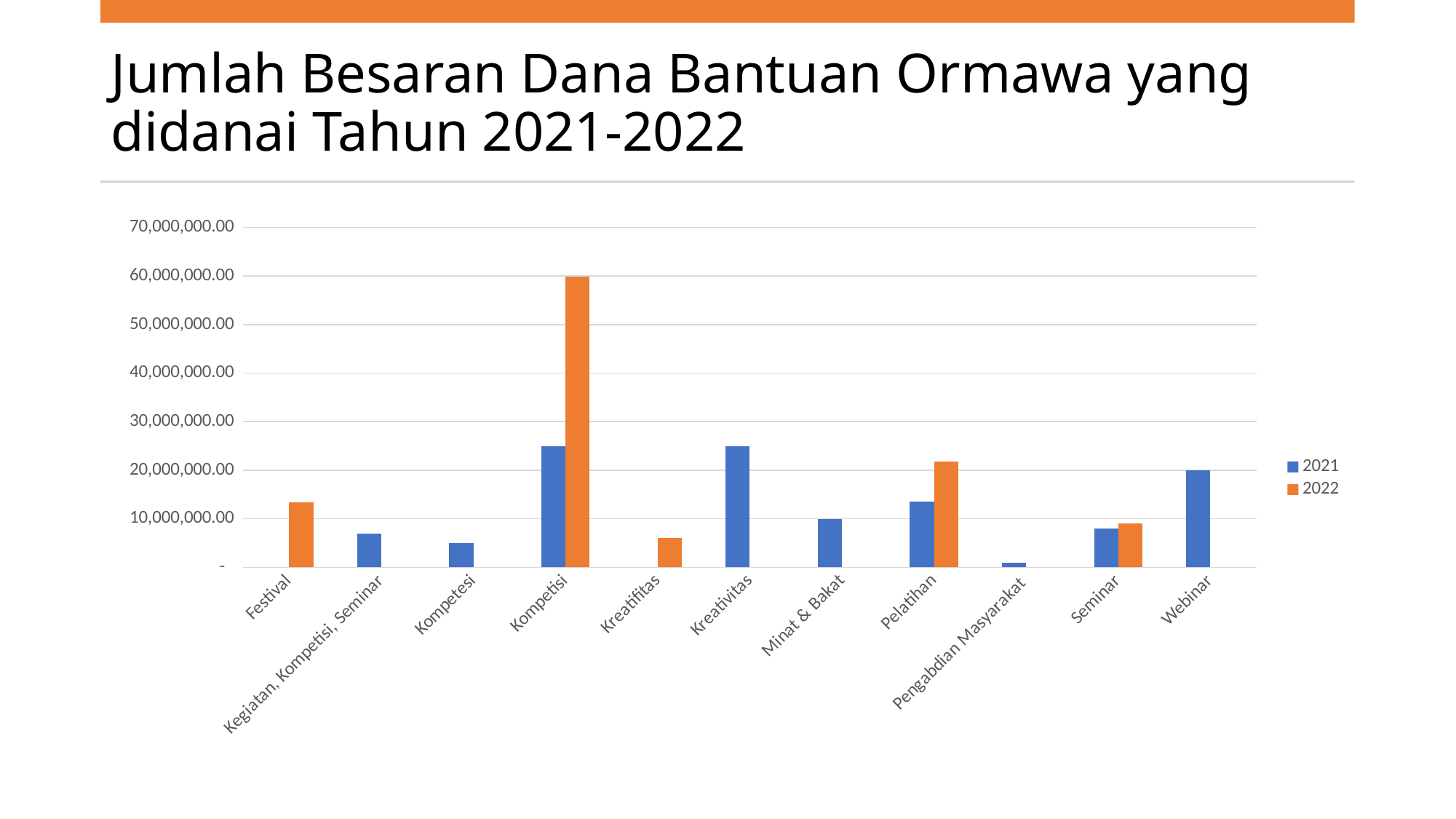
Which is larger, the 2021 value for Kreativitas or the 2021 value for Minat & Bakat? Kreativitas How many categories are shown on the x axis? 11 Which category has the lowest 2021 value? Pengabdian Masyarakat How many series does the legend list? 2 Is the 2022 value for Kompetisi greater or less than 50,000,000.00? greater Which is larger for Pelatihan, the 2021 value or the 2022 value? 2022 Is the 2021 value for Kompetesi greater or less than 10,000,000.00? less Is the 2022 value for Festival greater or less than 10,000,000.00? greater What kind of chart is shown on the slide? bar chart Which category has the highest 2022 value? Kompetisi What colour are the 2022 bars? orange